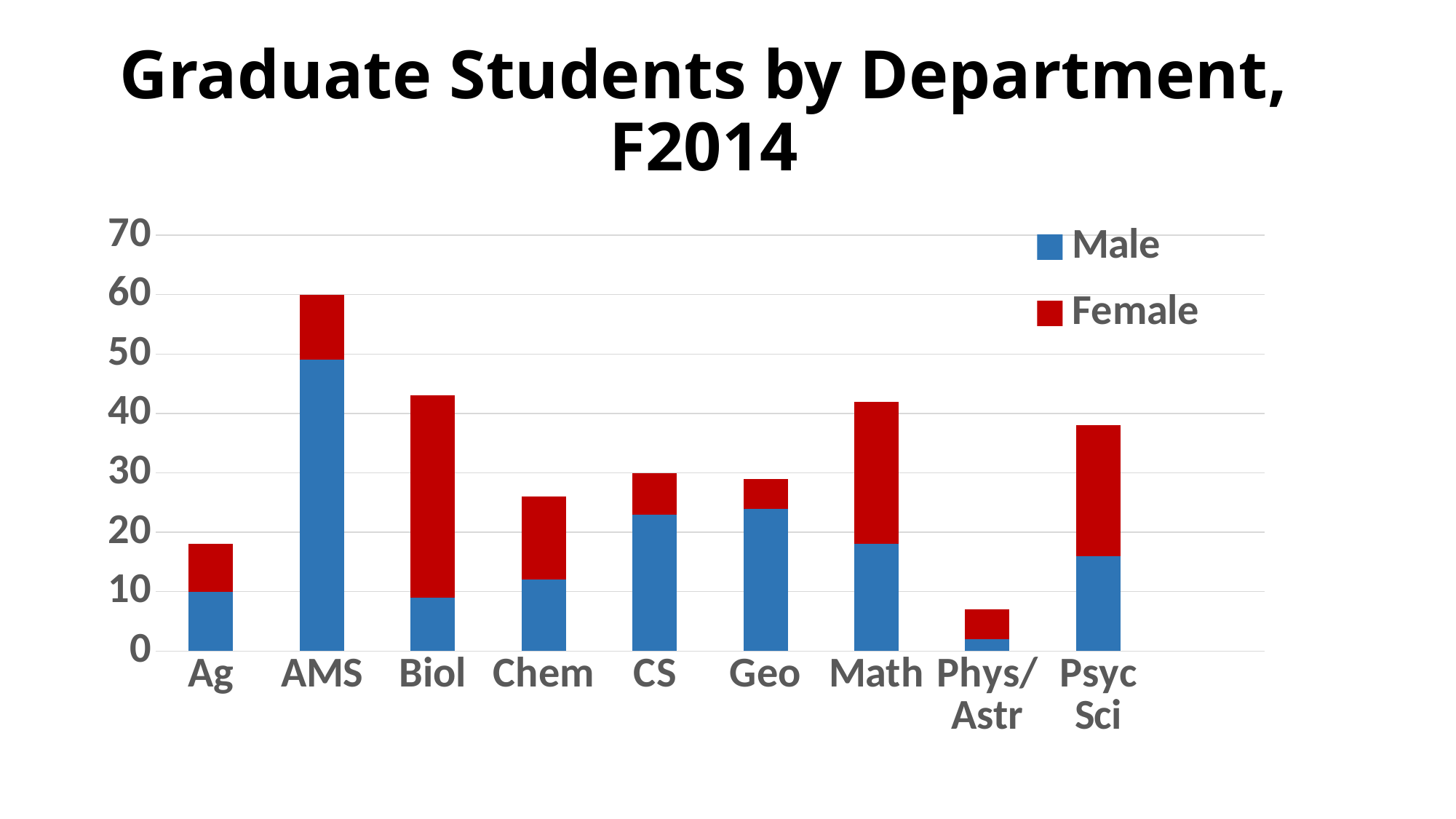
Is the total number of graduate students for Ag greater or less than 20? less Which department has the largest number of Female graduate students? Biol Which department has the lowest total number of graduate students? Phys/Astr What is the title of the chart? Graduate Students by Department, F2014 Which colour represents Female students in the chart? Red How many departments are shown on the x axis? 9 Which department has the largest number of Male graduate students? AMS What kind of chart is shown on the slide? Stacked bar chart Is the total number of graduate students for Psyc Sci greater or less than 30? greater Which department has more total graduate students, Psyc Sci or Chem? Psyc Sci Which department has the highest total number of graduate students? AMS How many series does the legend list? 2